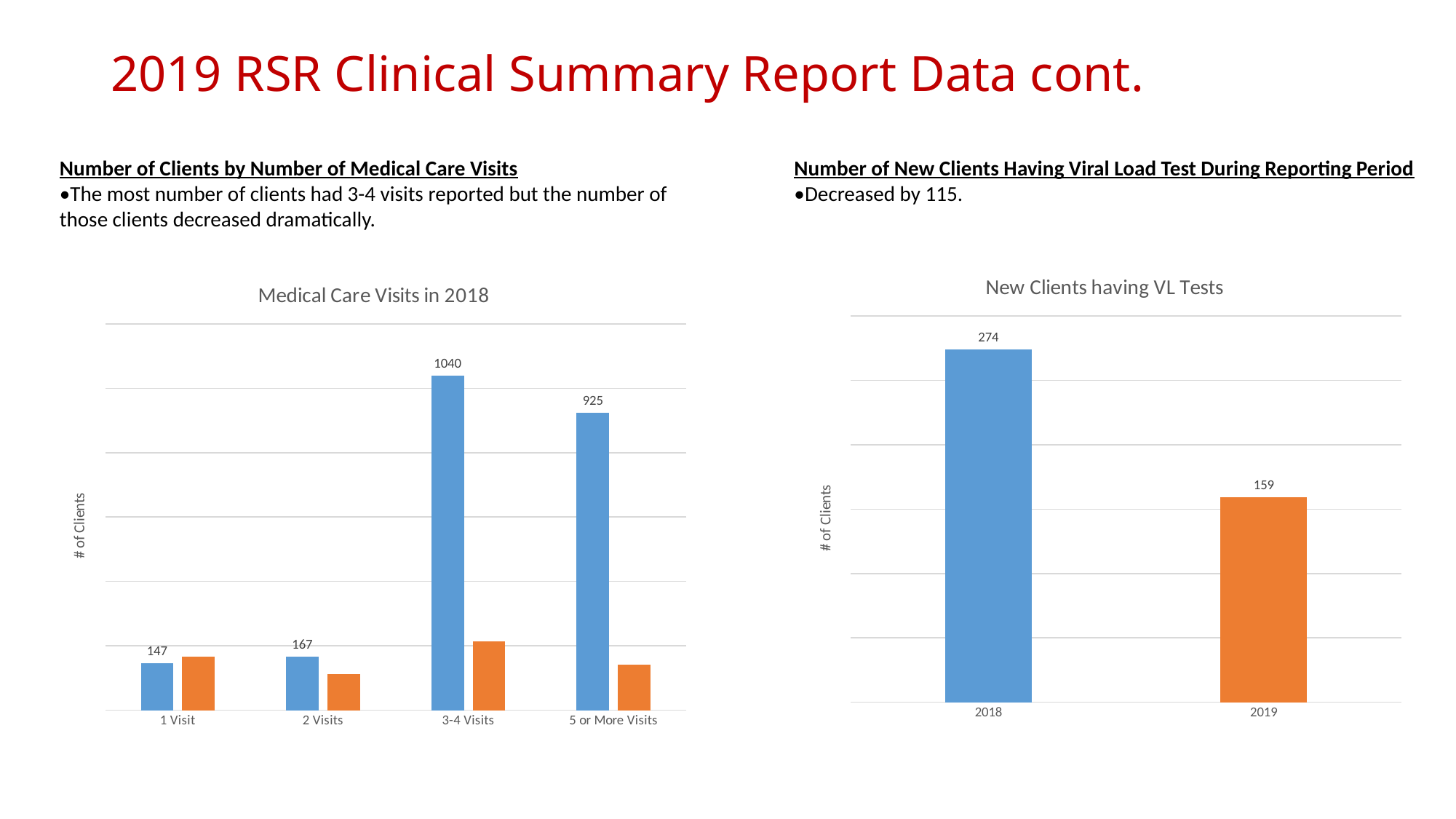
In the 'Medical Care Visits in 2018' chart, what value is labelled on the blue bar for 3-4 Visits? 1040 What is the y-axis label on the 'New Clients having VL Tests' chart? # of Clients In the 'Medical Care Visits in 2018' chart, which has the larger labelled value: 2 Visits or 1 Visit? 2 Visits In the 'New Clients having VL Tests' chart, what is the difference between the 2018 and 2019 values? 115 In the 'Medical Care Visits in 2018' chart, what value is labelled on the blue bar for 1 Visit? 147 In the 'Medical Care Visits in 2018' chart, which category has the highest labelled value? 3-4 Visits In the 'New Clients having VL Tests' chart, what is the value for 2018? 274 In the 'Medical Care Visits in 2018' chart, which category has the lowest labelled value? 1 Visit In the 'Medical Care Visits in 2018' chart, what is the difference between the labelled values for 3-4 Visits and 5 or More Visits? 115 How many visit categories are shown on the x axis of the 'Medical Care Visits in 2018' chart? 4 In the 'New Clients having VL Tests' chart, do the values rise or fall from 2018 to 2019? Fall What kind of chart is 'Medical Care Visits in 2018'? Bar chart